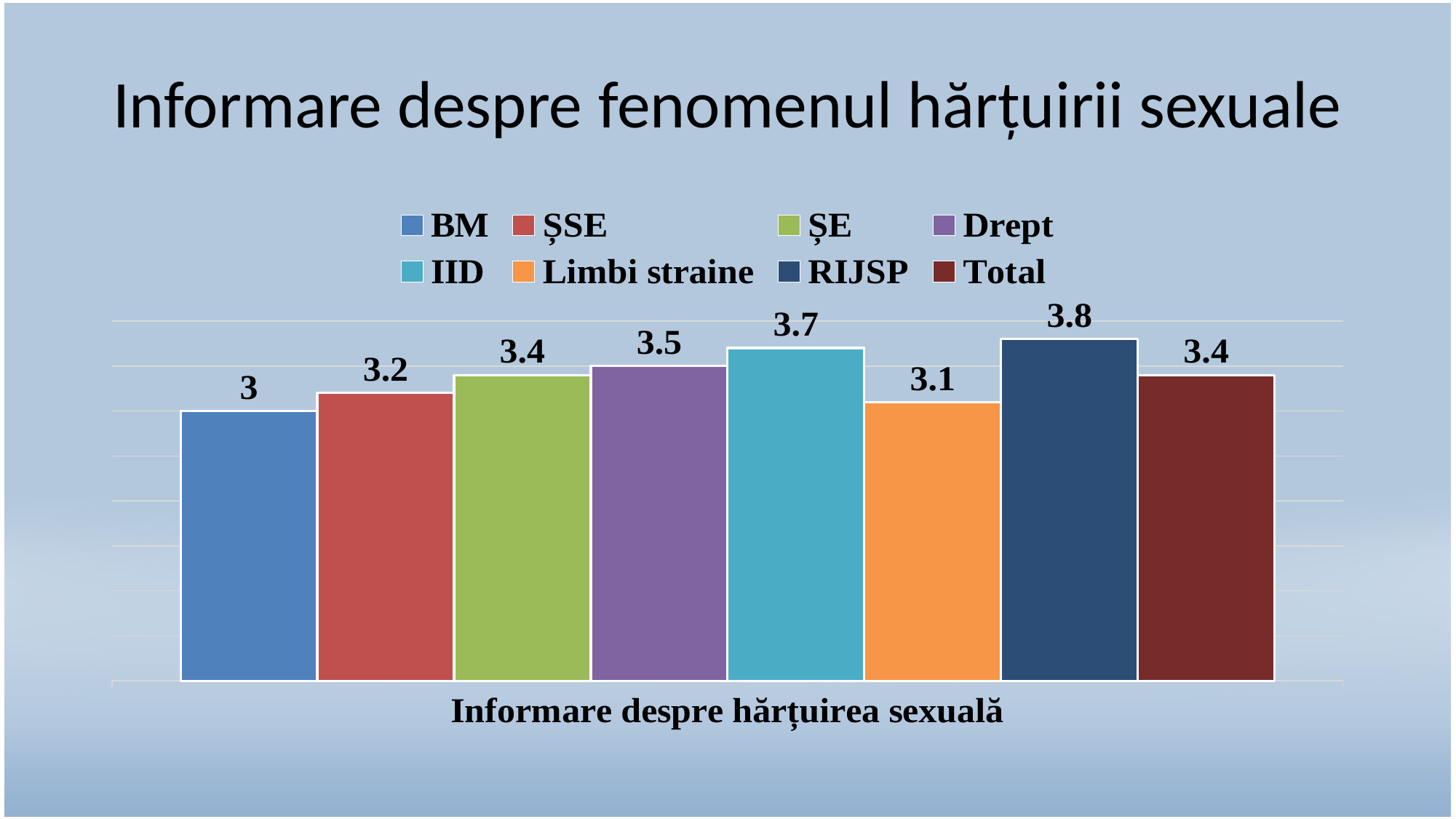
What is the value for Limbi straine? 3.1 What is the value for BM? 3 What is the difference between the values for RIJSP and BM? 0.8 What is the value for RIJSP? 3.8 Which is larger, the value for Drept or the value for ȘSE? Drept What is the label shown below the x axis of the chart? Informare despre hărțuirea sexuală How many series does the legend list? 8 What kind of chart is shown on the slide? Bar chart Which series has the highest value? RIJSP What is the difference between the values for IID and Limbi straine? 0.6 What is the value for Total? 3.4 Which series has the lowest value? BM